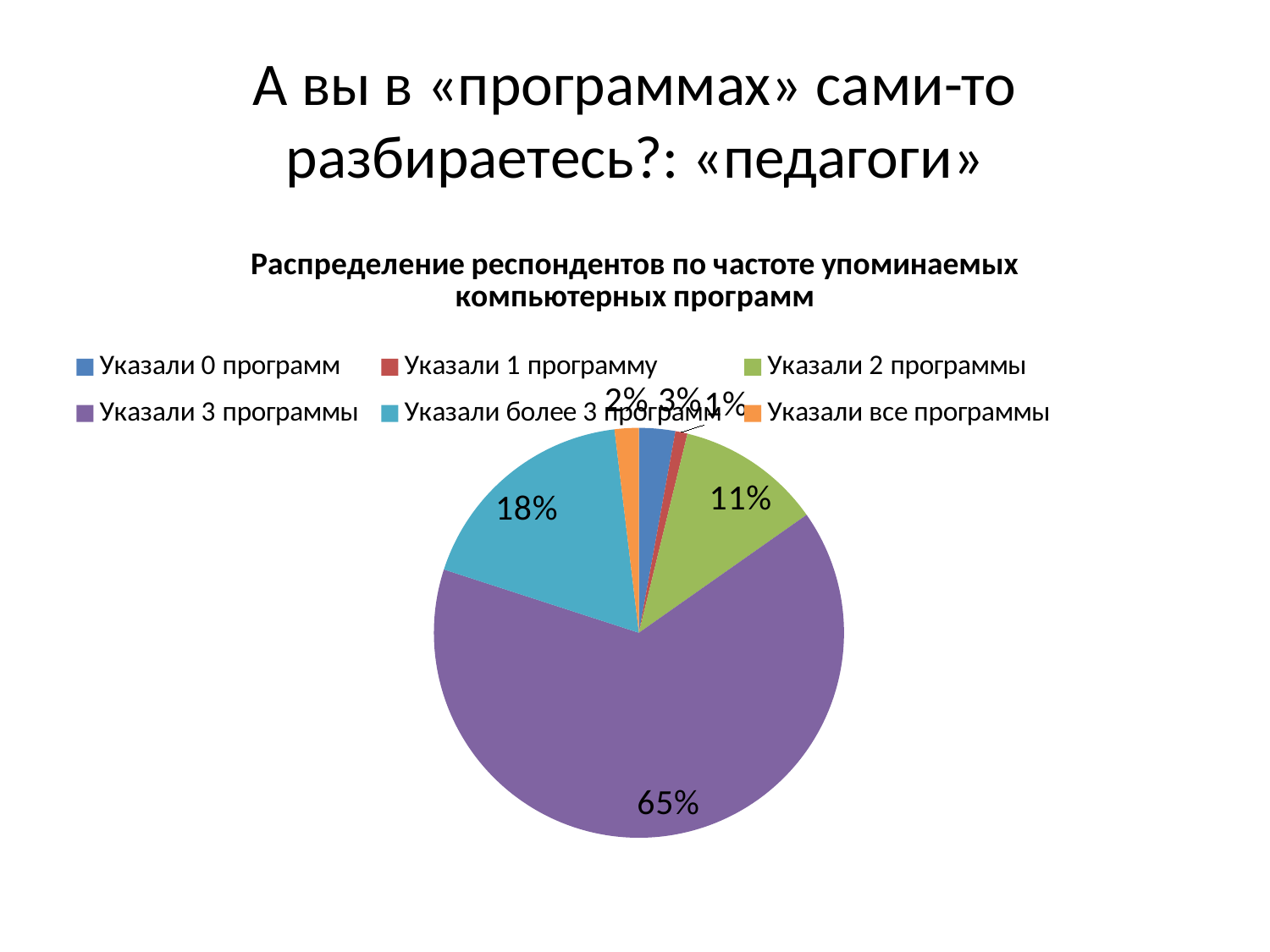
What share of respondents is shown for "Указали 2 программы"? 11% What is the difference between the shares for "Указали 3 программы" and "Указали более 3 программ"? 47% What is the title of the chart? Распределение респондентов по частоте упоминаемых компьютерных программ Which category has the largest share of the pie? Указали 3 программы How many slices does the pie chart have? 6 Which category has the smallest share of the pie? Указали 1 программу What share of respondents is shown for "Указали 3 программы"? 65% What colour is the slice for "Указали 3 программы"? purple What share of respondents is shown for "Указали более 3 программ"? 18% What kind of chart is shown on the slide? pie chart Which is larger: the share for "Указали 2 программы" or the share for "Указали более 3 программ"? Указали более 3 программ